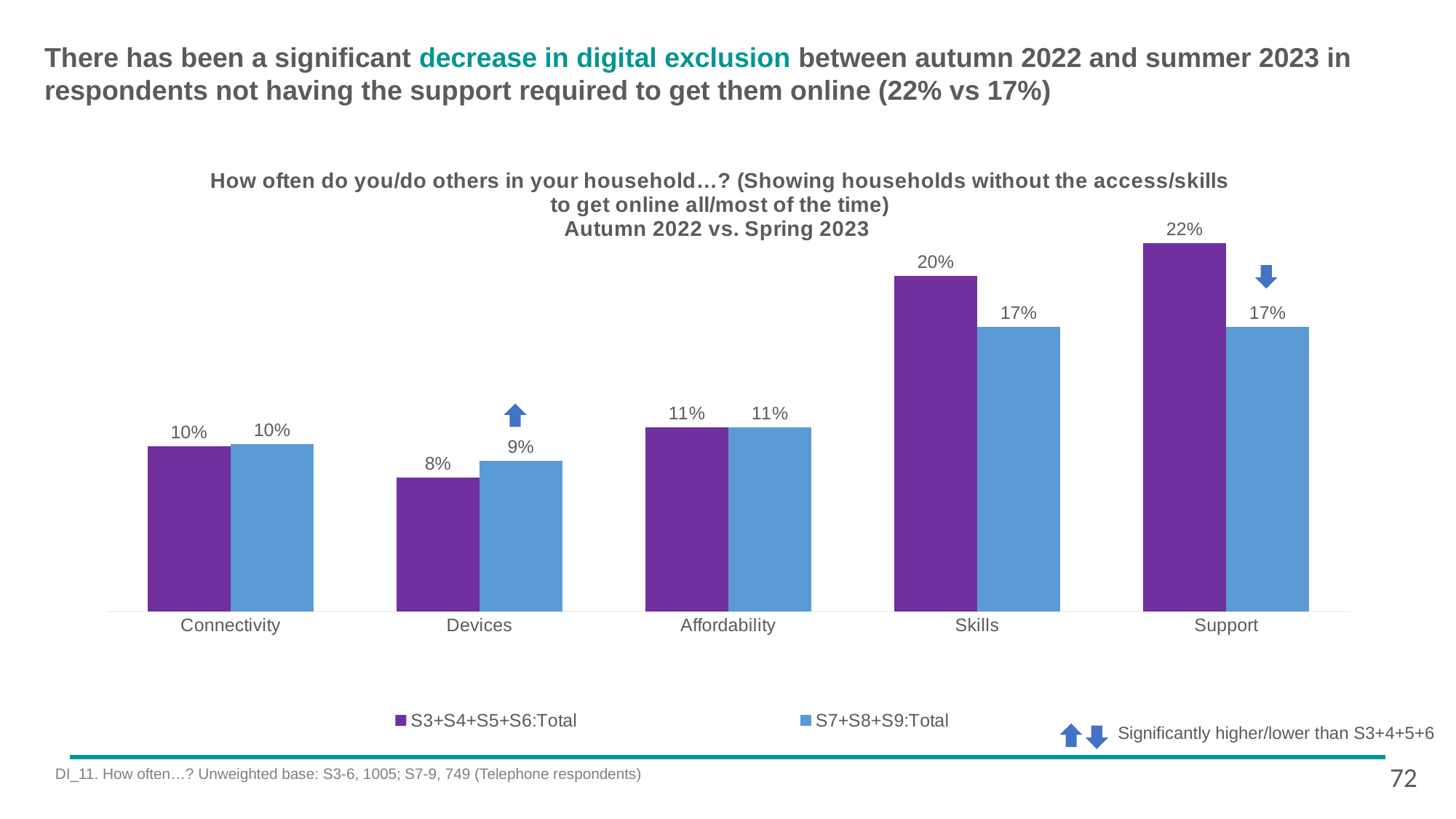
Which category has the highest value in the S3+S4+S5+S6:Total series? Support What is the difference between the S3+S4+S5+S6:Total and S7+S8+S9:Total values for Support? 5% What is the value for Affordability in the S7+S8+S9:Total series? 11% What is the value for Support in the S3+S4+S5+S6:Total series? 22% How many series does the legend list? 2 Which category has the lowest value in the S3+S4+S5+S6:Total series? Devices What is the value for Devices in the S7+S8+S9:Total series? 9% How many categories are shown on the x axis? 5 For Devices, which series has the larger value, S3+S4+S5+S6:Total or S7+S8+S9:Total? S7+S8+S9:Total What is the value for Skills in the S7+S8+S9:Total series? 17% What is the difference between the S3+S4+S5+S6:Total and S7+S8+S9:Total values for Skills? 3% What kind of chart is shown on the slide? Bar chart